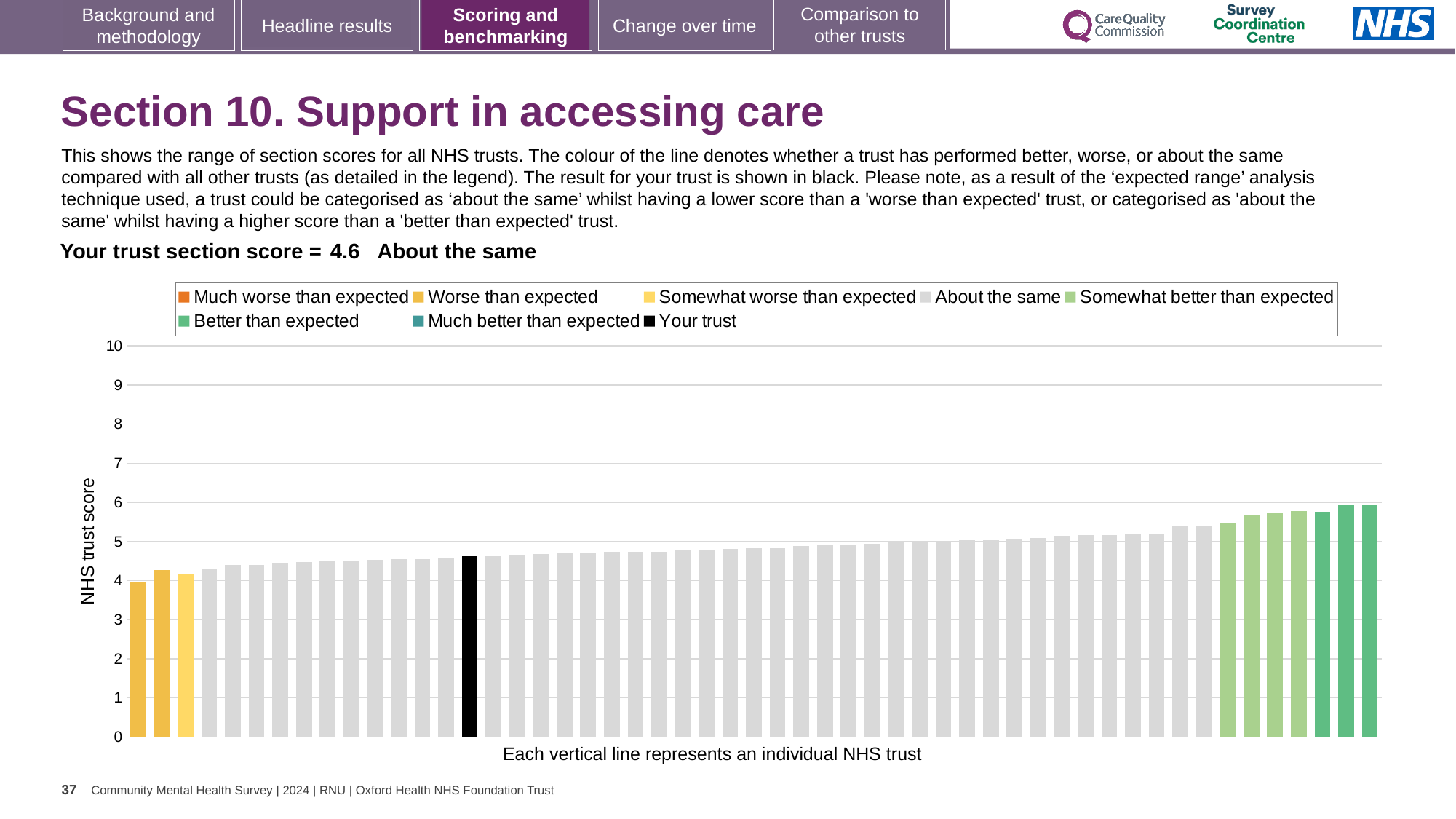
What kind of chart is shown on the slide? bar chart What colour is the bar representing your trust? black How many entries does the chart legend list? 8 What is the section score for your trust shown on the slide? 4.6 What is the label on the vertical axis of the chart? NHS trust score Which is larger, the leftmost bar or the rightmost bar? the rightmost bar How many bars are coloured as 'Worse than expected'? 2 Is the value for your trust (the black bar) greater or less than 5? less Do the bar values rise or fall from left to right along the x axis? rise Which category is your trust's section score placed in? About the same Is the value of the tallest bar greater or less than 5? greater Is the value of the leftmost bar greater or less than 5? less